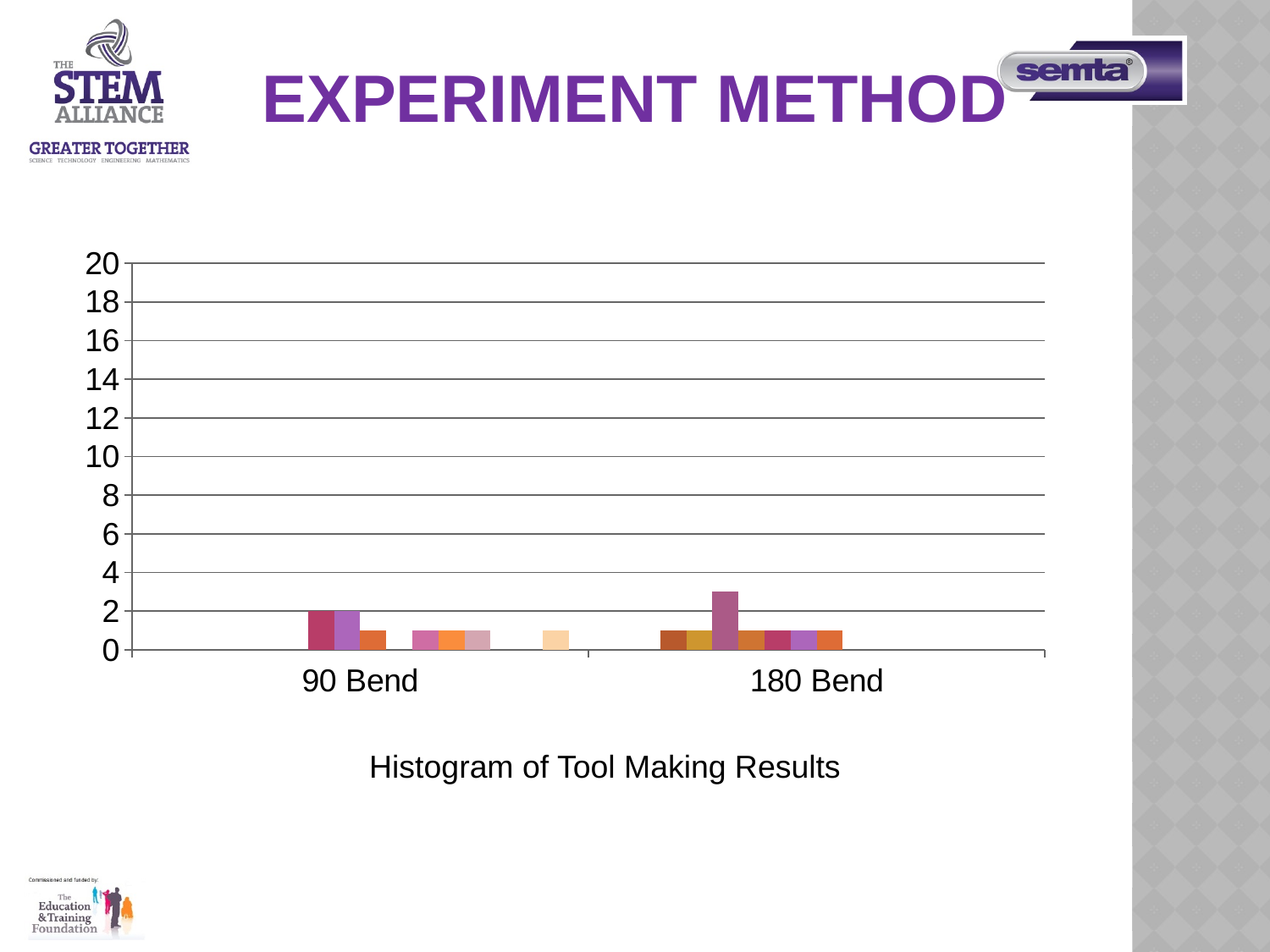
What are the two categories labelled on the x axis of the chart? 90 Bend and 180 Bend Is the tallest bar in the 90 Bend category greater or less than 4? less Is the tallest bar in the 90 Bend category greater or less than 10? less What is the caption printed below the chart? Histogram of Tool Making Results Which category contains the tallest bar in the chart? 180 Bend Is the tallest bar in the 180 Bend category greater or less than 4? less Is the tallest bar in the 180 Bend category taller than the tallest bar in the 90 Bend category? yes How many categories are shown on the x axis of the chart? 2 What kind of chart is shown on the slide? bar chart